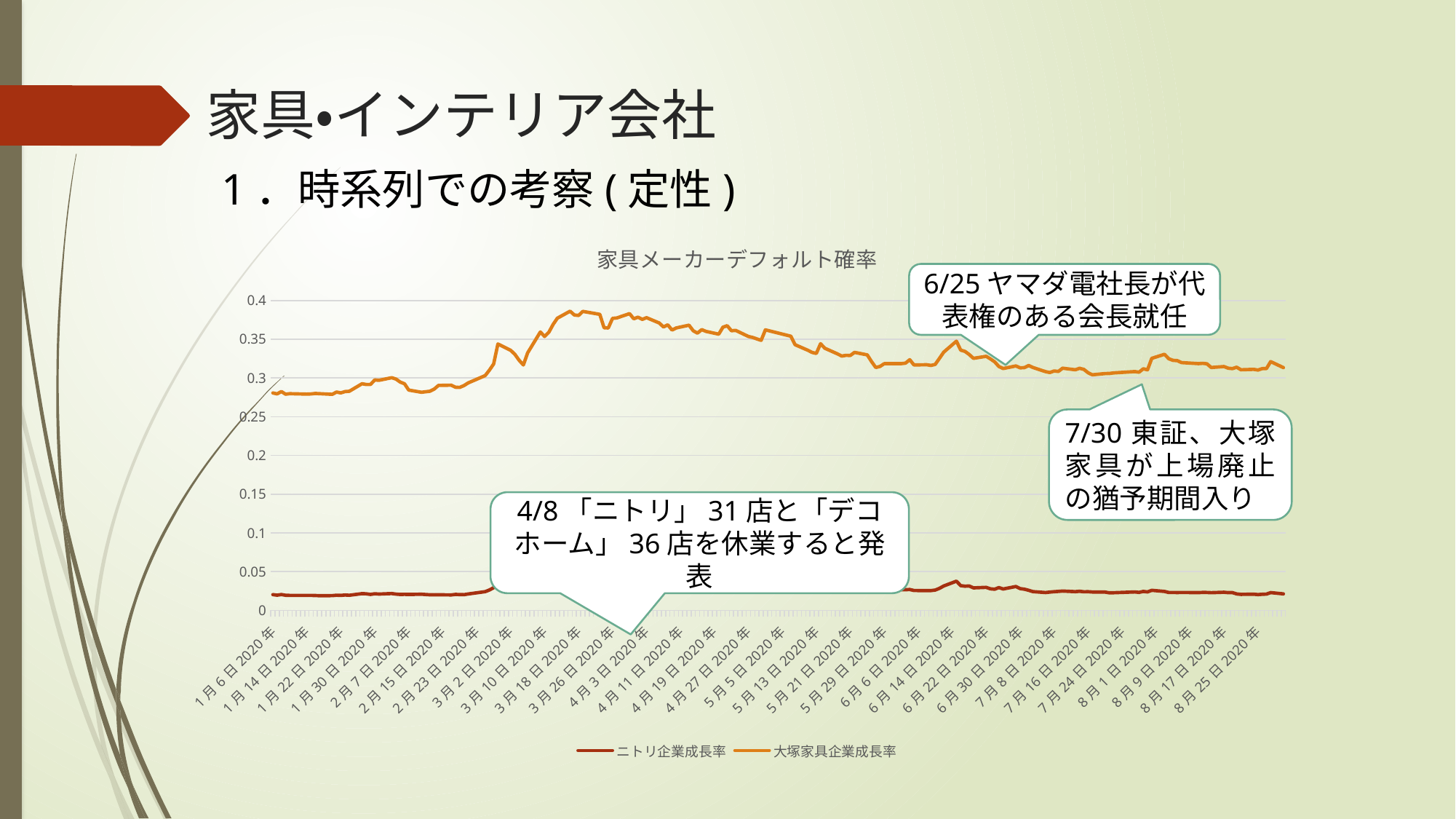
Does the 大塚家具企業成長率 line rise or fall between 3月2日2020年 and 3月18日2020年? rise How many series does the legend list? 2 Which series has the higher values across the whole period, ニトリ企業成長率 or 大塚家具企業成長率? 大塚家具企業成長率 Is the value for 大塚家具企業成長率 at 8月25日2020年 greater or less than 0.3? greater What is the title of the chart? 家具メーカーデフォルト確率 What kind of chart is shown on the slide? line chart Is the value for 大塚家具企業成長率 at 3月18日2020年 greater or less than 0.35? greater Is the value for 大塚家具企業成長率 at 1月6日2020年 greater or less than 0.3? less Which series reaches the highest value on the chart? 大塚家具企業成長率 Which series is drawn in orange? 大塚家具企業成長率 Does the 大塚家具企業成長率 line rise or fall between 3月26日2020年 and 5月29日2020年? fall